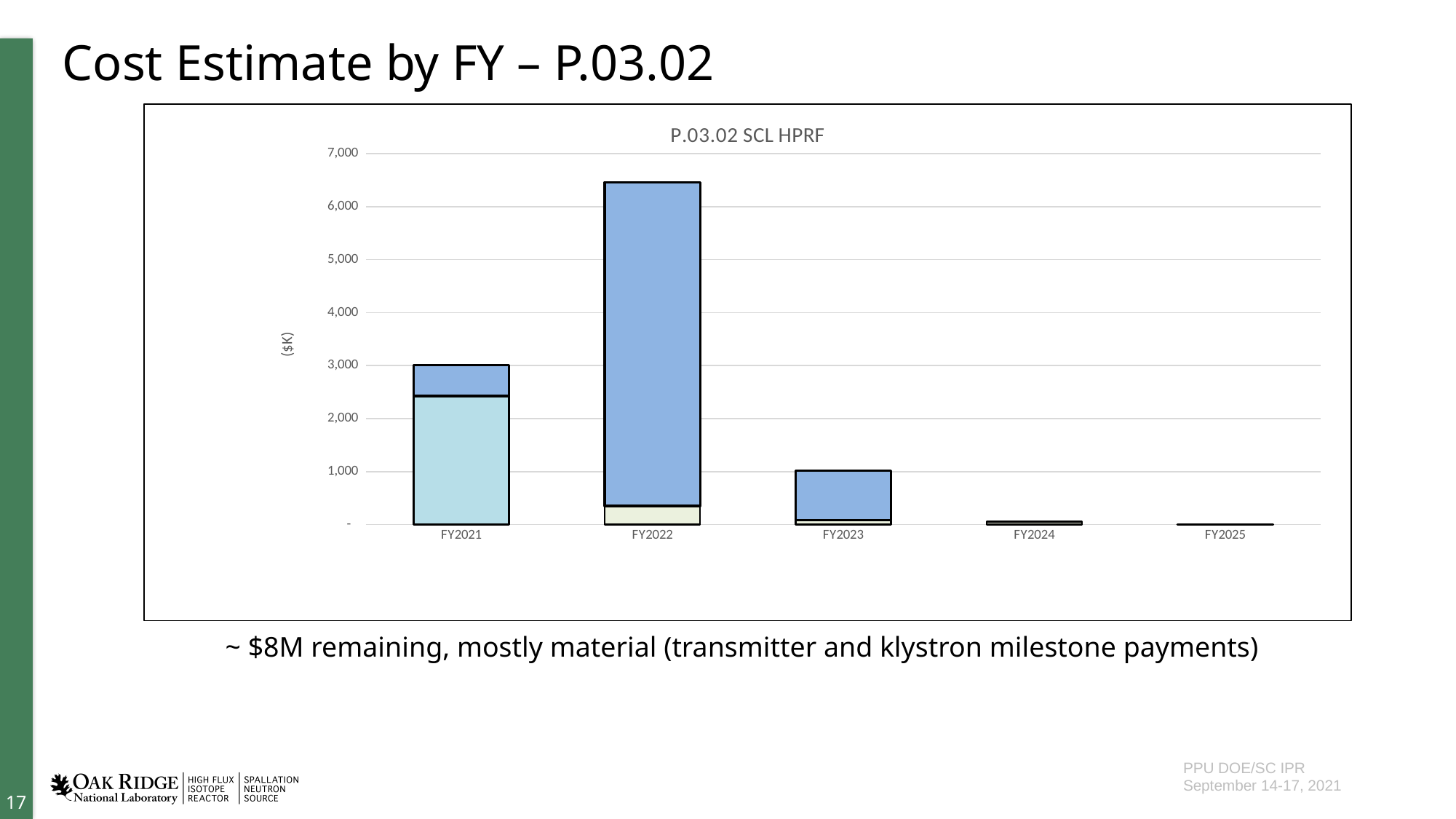
Do the total bar values rise or fall from FY2022 to FY2025? fall What kind of chart is shown on the slide? bar chart Is the total value for FY2022 greater or less than 6,000? greater Is the total value for FY2021 greater or less than 4,000? less Which has the larger total bar, FY2021 or FY2023? FY2021 What is the title of the chart? P.03.02 SCL HPRF Is the total value for FY2023 greater or less than 2,000? less How many fiscal years are shown on the x axis of the chart? 5 What is the label on the vertical axis of the chart? ($K) Which fiscal year has the highest total bar? FY2022 Which fiscal year has the lowest total bar? FY2025